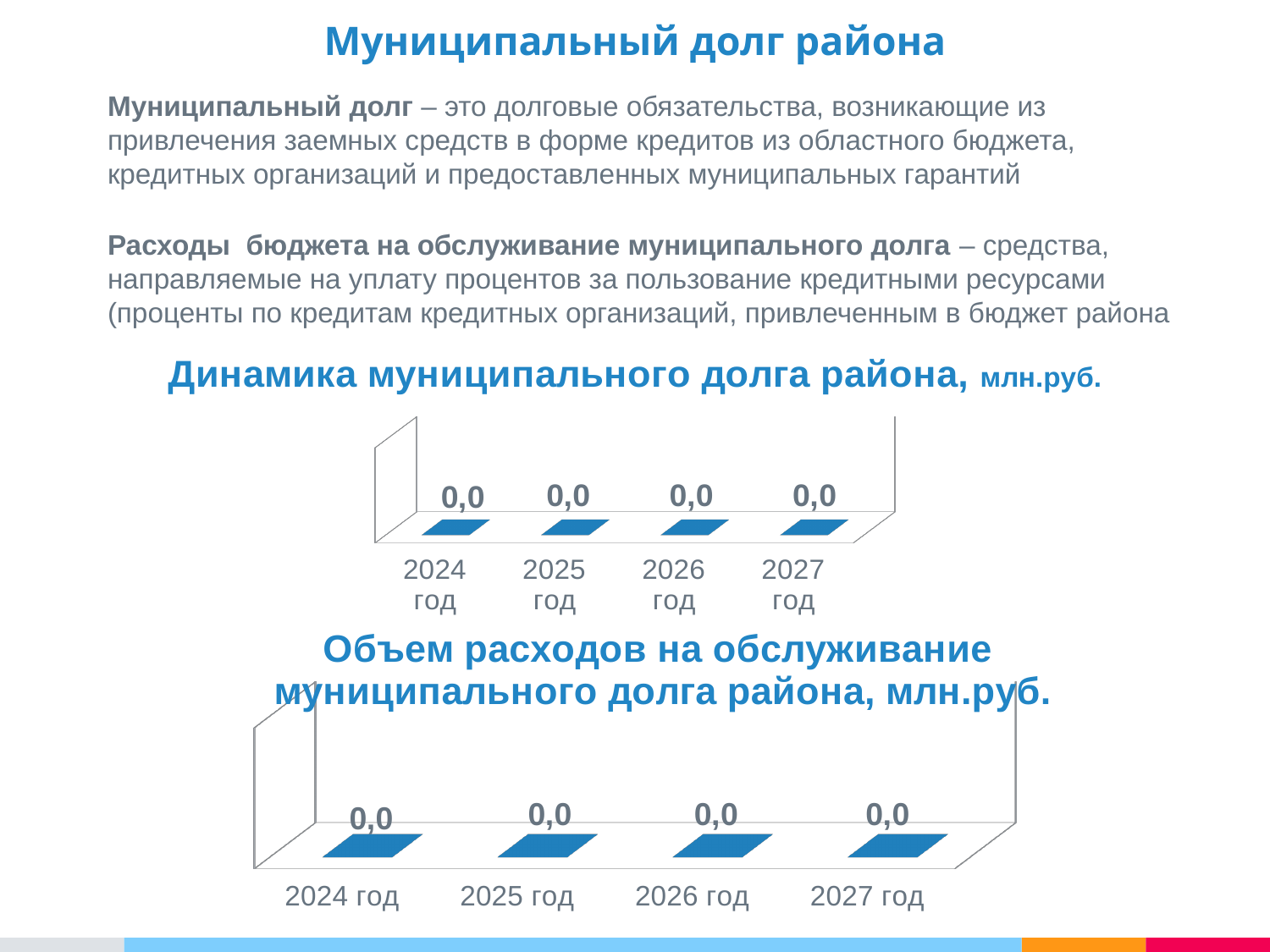
What is the title of the lower chart on the slide? Объем расходов на обслуживание муниципального долга района, млн.руб. In the chart 'Динамика муниципального долга района, млн.руб.', what is the value for 2024 год? 0,0 In the chart 'Объем расходов на обслуживание муниципального долга района, млн.руб.', what is the value for 2025 год? 0,0 What kind of chart is 'Динамика муниципального долга района, млн.руб.'? Bar chart In the chart 'Объем расходов на обслуживание муниципального долга района, млн.руб.', what is the difference between the values for 2027 год and 2024 год? 0,0 How many categories are shown in the chart 'Динамика муниципального долга района, млн.руб.'? 4 In the chart 'Объем расходов на обслуживание муниципального долга района, млн.руб.', what is the value for 2026 год? 0,0 In the chart 'Динамика муниципального долга района, млн.руб.', what is the value for 2027 год? 0,0 What kind of chart is 'Объем расходов на обслуживание муниципального долга района, млн.руб.'? Bar chart How many categories are shown in the chart 'Объем расходов на обслуживание муниципального долга района, млн.руб.'? 4 In the chart 'Динамика муниципального долга района, млн.руб.', do the values rise, fall or stay the same from 2024 год to 2027 год? Stay the same What unit is given in the title of the upper chart 'Динамика муниципального долга района'? млн.руб.